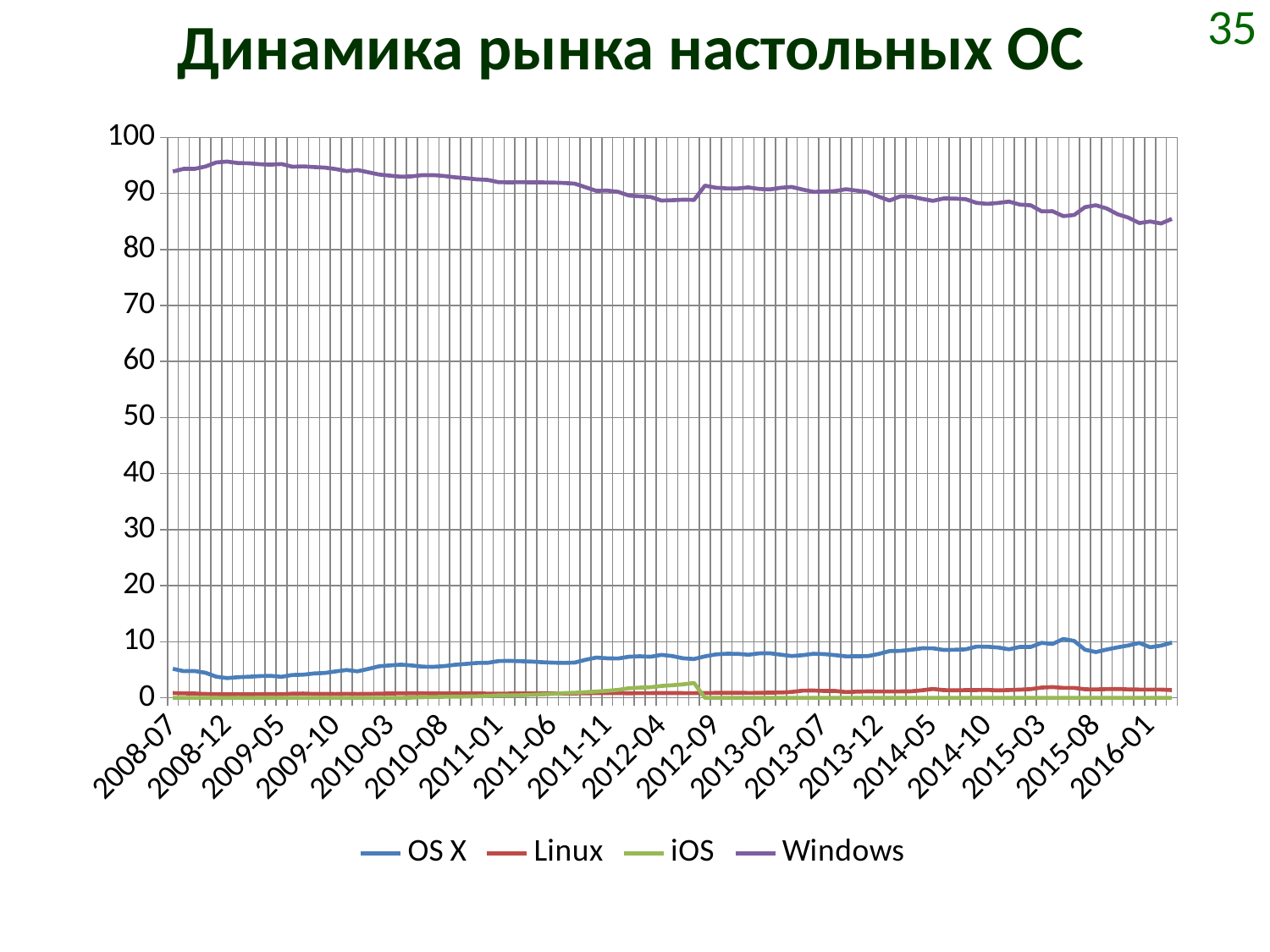
Which is larger at 2016-01, the value for OS X or the value for Linux? OS X Is the value for Windows at 2008-12 greater or less than 90? greater Is the value for OS X at 2015-08 greater or less than 20? less How many series does the legend list? 4 Which is larger at 2012-04, the value for Windows or the value for OS X? Windows Is the value for Windows at 2016-01 greater or less than 90? less Does the OS X line rise or fall from 2008-07 to 2016-01? rise Which series has the highest values throughout the chart? Windows Which series is plotted with the purple line? Windows What kind of chart is shown on the slide? line chart What is the title of the chart? Динамика рынка настольных ОС Does the Windows line rise or fall from 2008-07 to 2016-01? fall